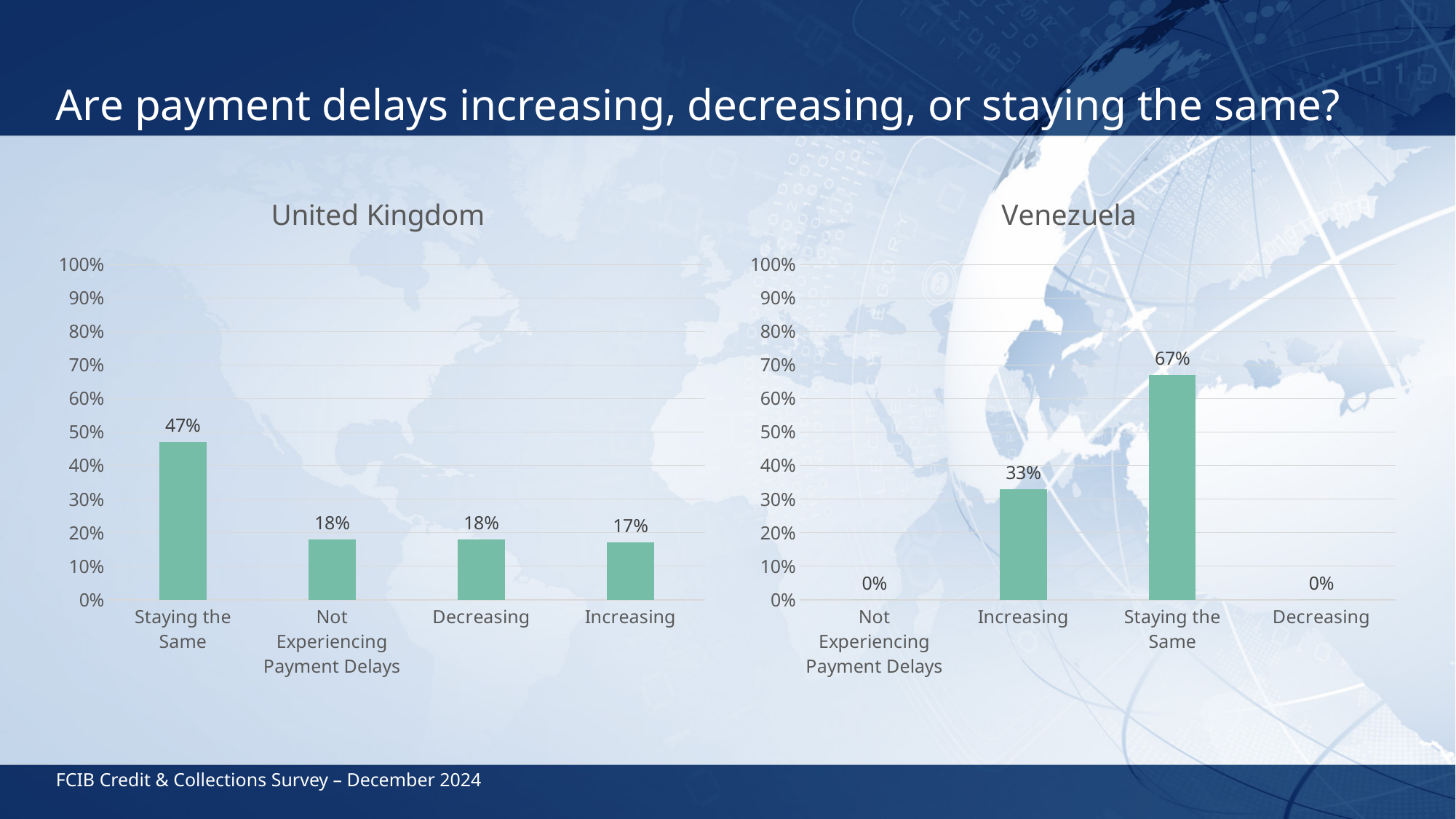
In the United Kingdom chart, which category has the highest value? Staying the Same In the Venezuela chart, what is the value for Decreasing? 0% In the Venezuela chart, what is the value for Increasing? 33% In the United Kingdom chart, what is the value for Staying the Same? 47% In the Venezuela chart, which category has the highest value? Staying the Same In the United Kingdom chart, what is the difference between Staying the Same and Decreasing? 29% What kind of chart is the United Kingdom chart? Bar chart In the Venezuela chart, what is the difference between Staying the Same and Increasing? 34% Which is larger: Staying the Same in the United Kingdom chart or Staying the Same in the Venezuela chart? Venezuela In the United Kingdom chart, which category has the lowest value? Increasing In the United Kingdom chart, what is the value for Increasing? 17% How many categories does the Venezuela chart show? 4